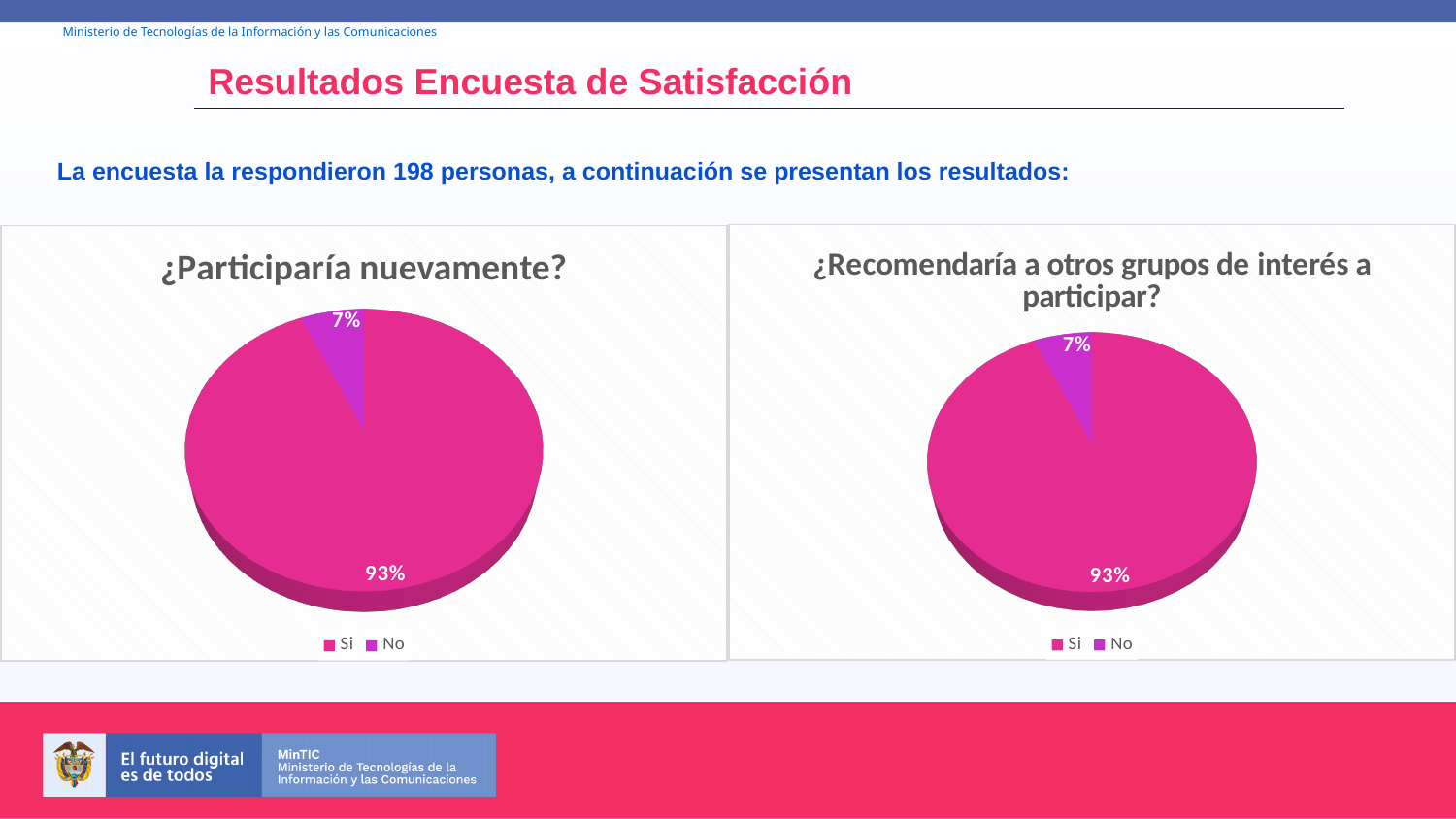
How many charts are shown on the slide? 2 In the '¿Participaría nuevamente?' chart, what is the difference in percentage points between Si and No? 86 In the '¿Recomendaría a otros grupos de interés a participar?' chart, which category has the smallest slice? No In the '¿Participaría nuevamente?' chart, which category has the largest slice? Si In the '¿Recomendaría a otros grupos de interés a participar?' chart, what percentage answered No? 7% In the '¿Participaría nuevamente?' chart, what percentage of respondents answered Si? 93% In the '¿Recomendaría a otros grupos de interés a participar?' chart, which is larger, Si or No? Si In the '¿Participaría nuevamente?' chart, what percentage of respondents answered No? 7% In the '¿Recomendaría a otros grupos de interés a participar?' chart, what percentage answered Si? 93% How many categories does the legend of the '¿Recomendaría a otros grupos de interés a participar?' chart list? 2 What are the legend entries in the '¿Participaría nuevamente?' chart? Si, No What type of chart is the '¿Participaría nuevamente?' chart? Pie chart